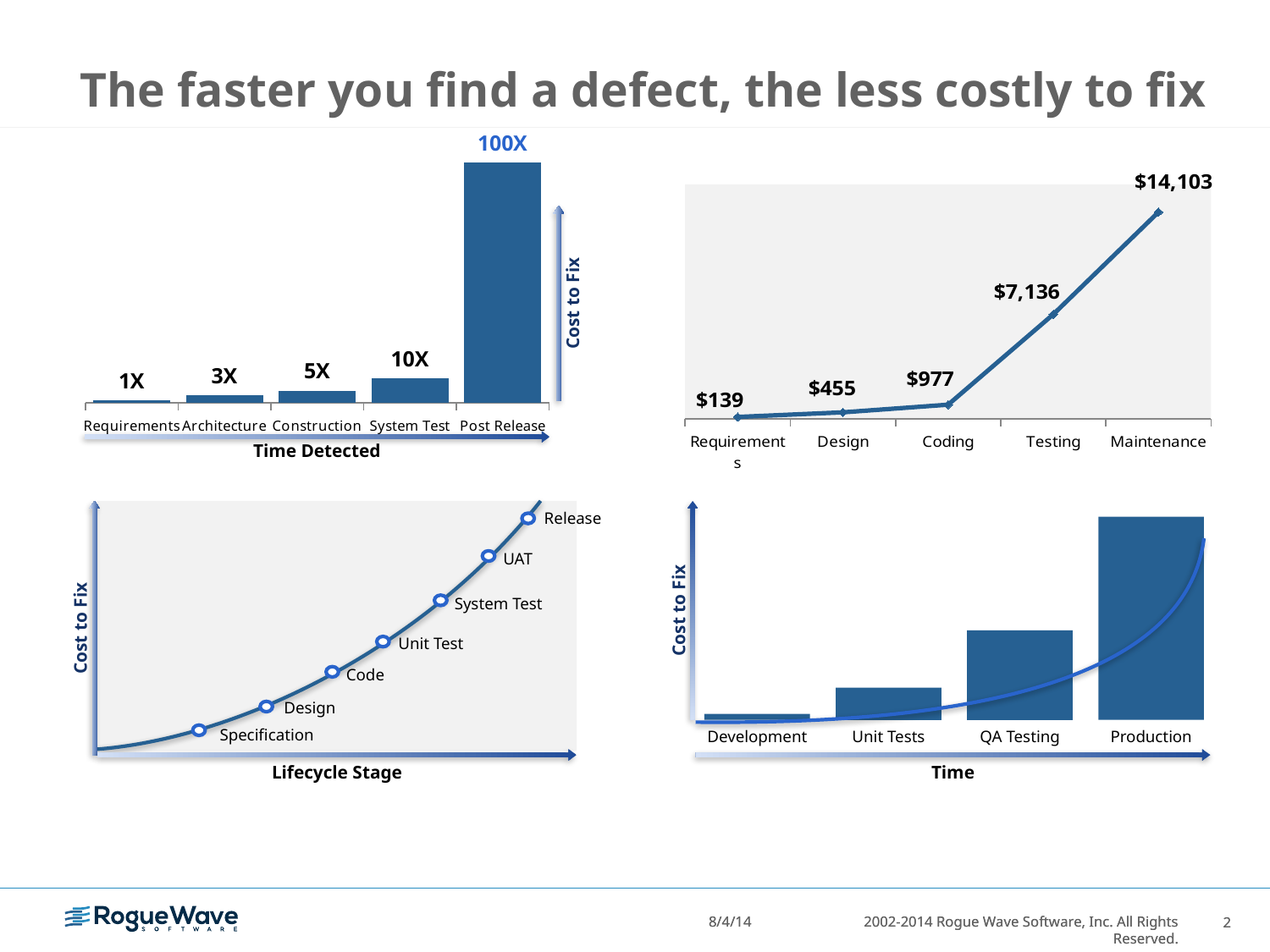
In the bottom-right bar chart, which category has the highest bar? Production What kind of chart is the bottom-right chart? bar chart How many labelled points are on the curve in the bottom-left chart? 7 In the top-left bar chart, which category has the lowest cost to fix? Requirements In the top-left bar chart, what is the value for Construction? 5X In the top-right line chart, do the values rise or fall from Requirements to Maintenance? rise In the top-right line chart, what is the difference between the values for Maintenance and Testing? $6,967 In the top-right line chart, what is the value for Testing? $7,136 In the top-right line chart, what is the value for Design? $455 In the top-right line chart, which category has the highest value? Maintenance How many categories are shown on the x axis of the top-left bar chart? 5 In the top-left bar chart, what is the value for Post Release? 100X